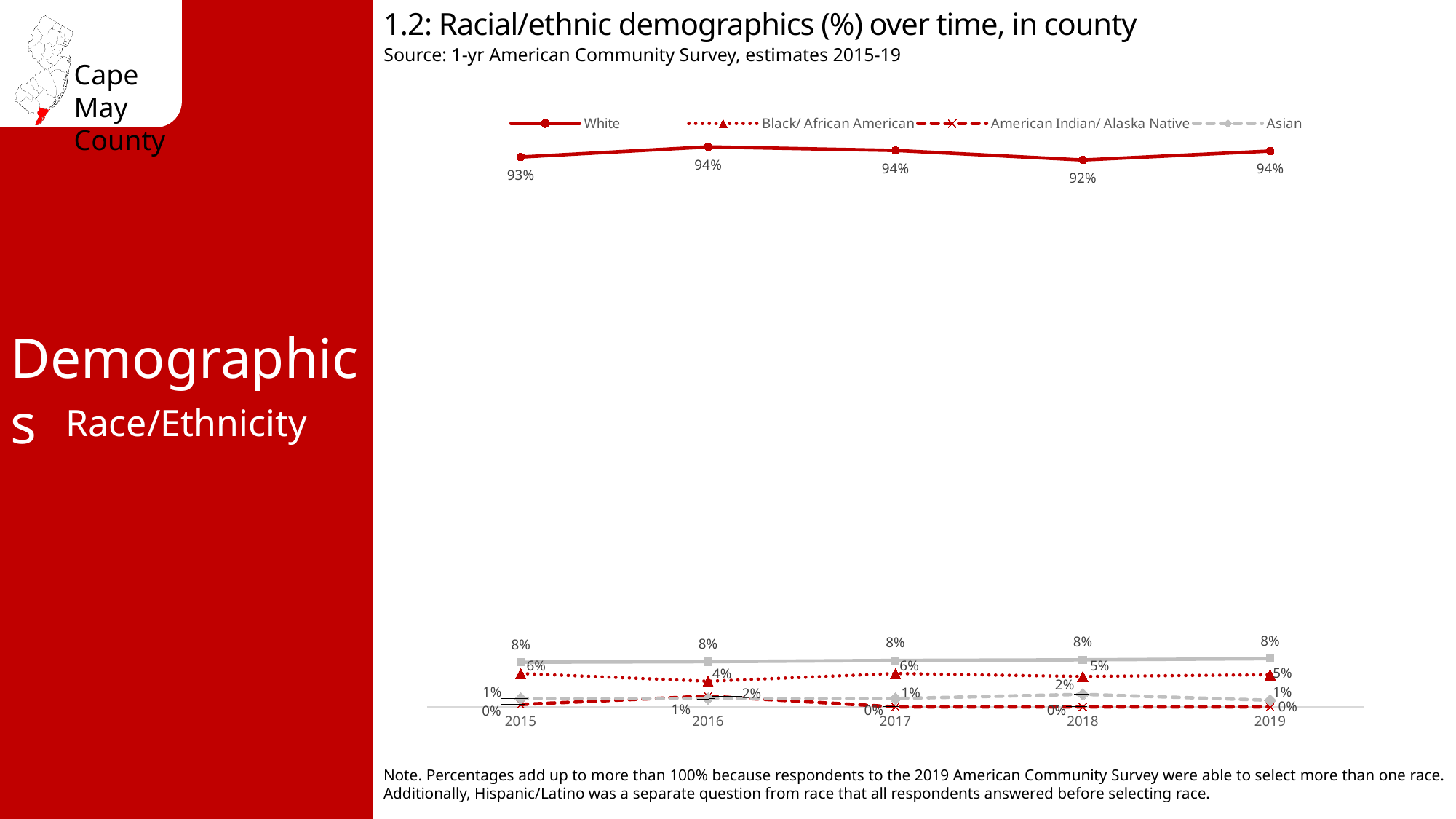
What is the difference between the White value in 2016 and in 2018? 2% What is the value for White in 2018? 92% How many years are shown on the x axis? 5 What is the value for Black/ African American in 2016? 4% What is the value for Asian in 2018? 2% What kind of chart is this? Line chart What is the value for American Indian/ Alaska Native in 2016? 2% Which year has the larger Black/ African American value, 2015 or 2016? 2015 Does the White value rise or fall from 2015 to 2016? Rise What is the value for White in 2015? 93% In which year is the White percentage lowest? 2018 What is the value for Black/ African American in 2015? 6%